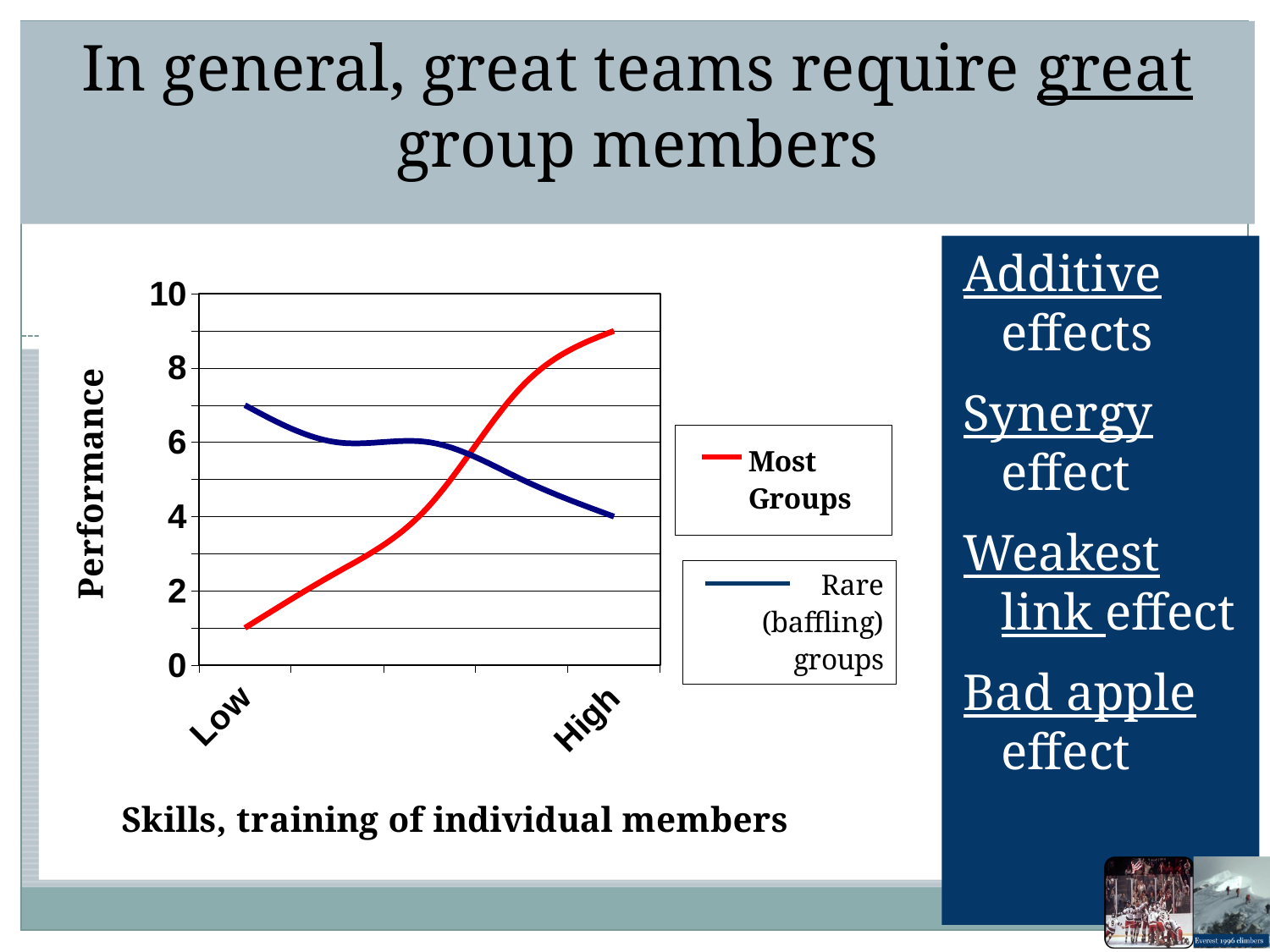
Does the Most Groups line rise or fall as skills go from Low to High? rise What are the two series named in the legend? Most Groups; Rare (baffling) groups Is the value for Rare (baffling) groups at High greater or less than 6? less What is the label on the vertical axis? Performance What kind of chart is shown on the slide? line chart Is the value for Most Groups at Low greater or less than 2? less At the Low end of the x axis, which series has the higher performance? Rare (baffling) groups Does the Rare (baffling) groups line rise or fall as skills go from Low to High? fall At the High end of the x axis, which series has the higher performance? Most Groups Is the value for Most Groups at High greater or less than 8? greater How many series does the legend list? 2